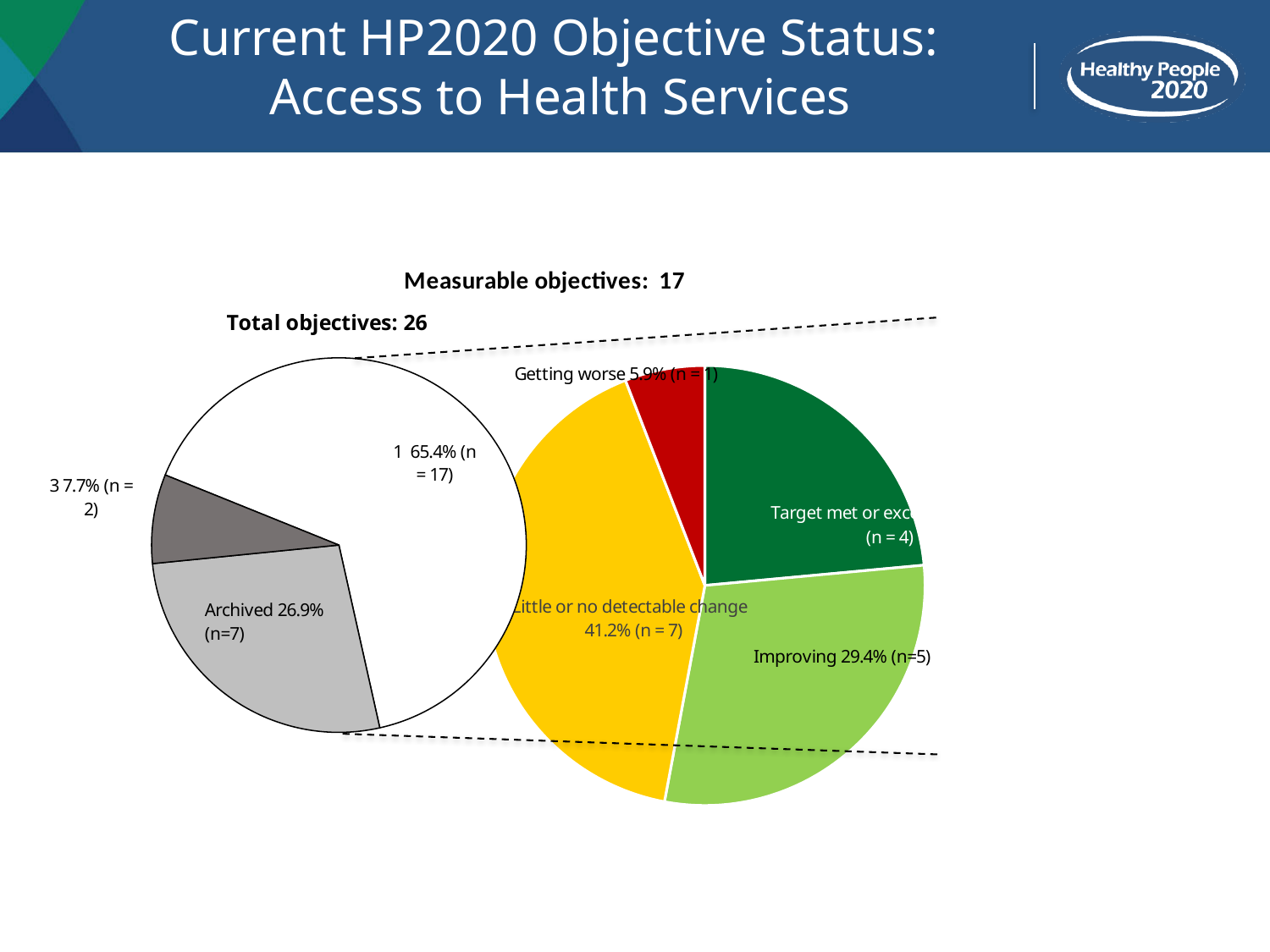
In the Total objectives pie chart, what percentage of objectives are Archived? 26.9% In the Measurable objectives pie chart, which category has the smallest share? Getting worse In the Measurable objectives pie chart, how many objectives show Little or no detectable change? 7 In the Measurable objectives pie chart, which category has the largest share? Little or no detectable change How many total objectives are shown on the slide? 26 In the Measurable objectives pie chart, what share of objectives are Improving? 29.4% In the Total objectives pie chart, how many objectives are in the 65.4% slice? 17 In the Measurable objectives pie chart, how many objectives have the Target met or exceeded? 4 What type of charts are shown on the slide? Pie charts In the Measurable objectives pie chart, what is the difference in percentage points between Little or no detectable change and Improving? 11.8 In the Measurable objectives pie chart, what percentage of objectives are Getting worse? 5.9% In the Total objectives pie chart, how many slices are there? 3